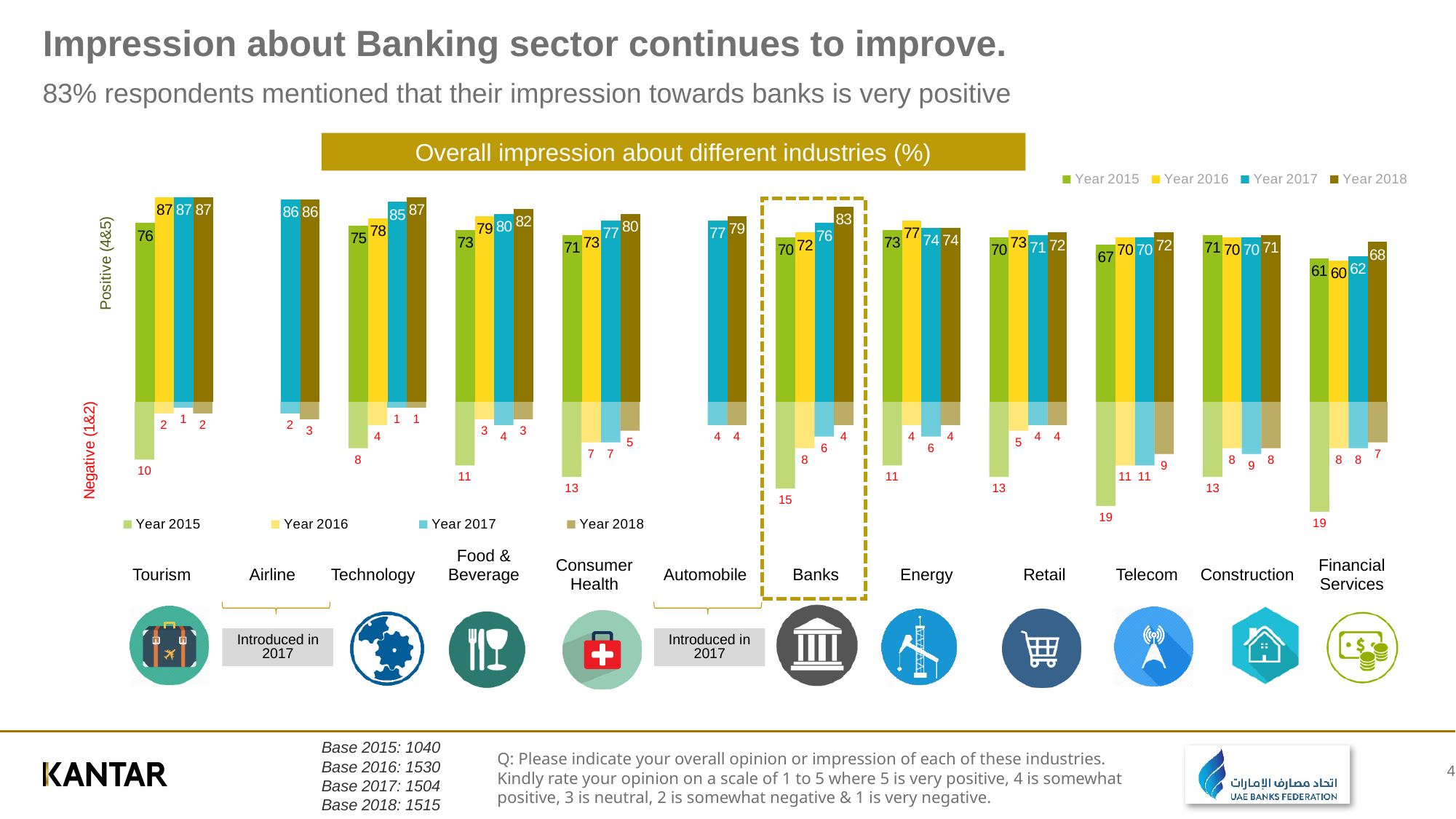
How many series does the legend list? 4 What is the negative impression value for Telecom in Year 2015? 19 Which industry has the highest positive impression value in Year 2015? Tourism Which is larger: the Year 2018 positive value for Technology or for Food & Beverage? Technology Which industry has the lowest positive impression value in Year 2018? Financial Services Which two industries were introduced in 2017? Airline and Automobile How many industries are shown on the chart? 12 What kind of chart is used to show the overall impression about different industries? Bar chart Do the positive impression values for Banks rise or fall from Year 2015 to Year 2018? Rise What is the positive impression value for Banks in Year 2018? 83 By how much did the positive impression for Banks increase from Year 2017 to Year 2018? 7 What is the difference between the Year 2015 and Year 2018 negative values for Banks? 11